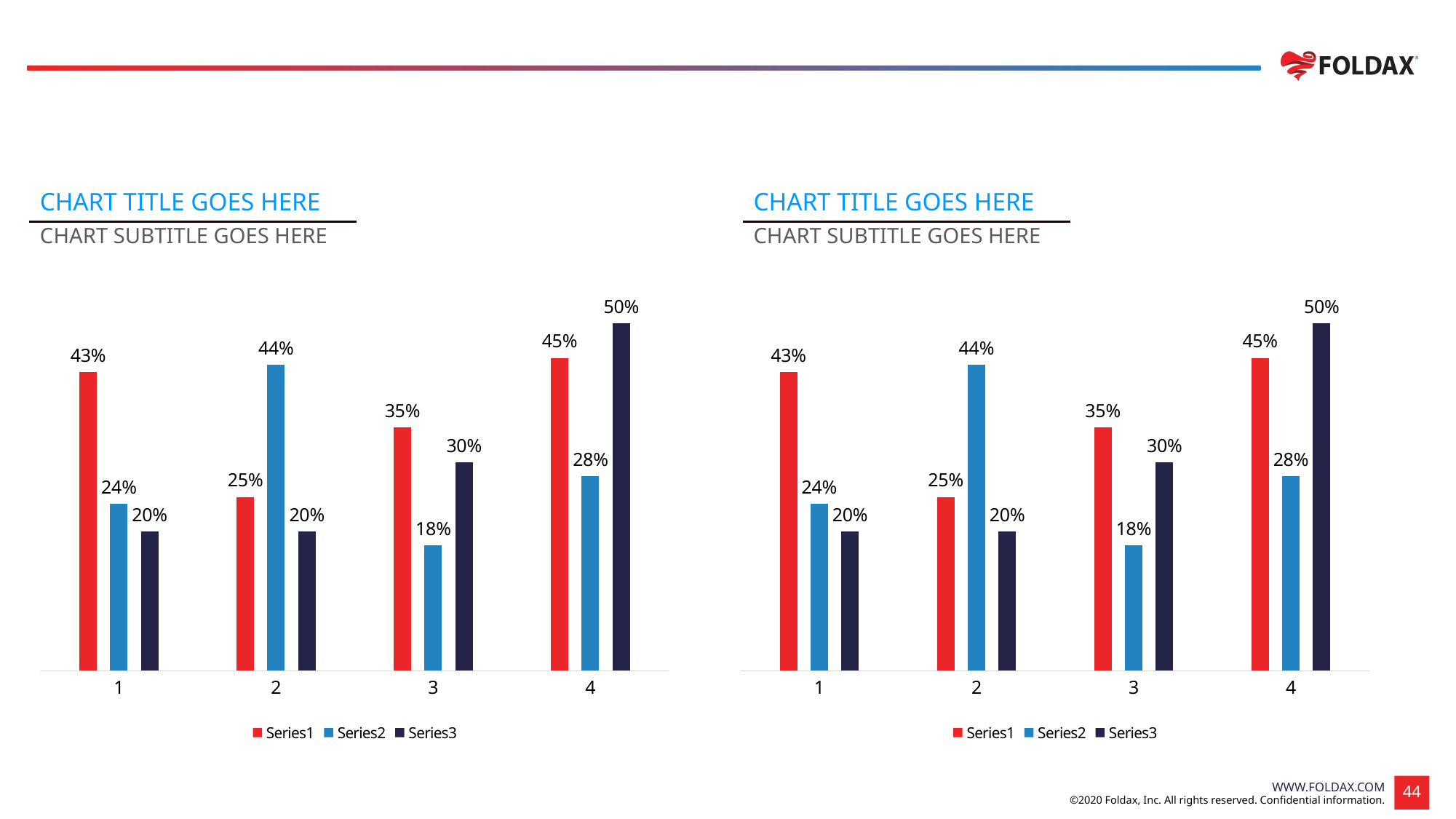
In the left chart, what is the value of Series2 for category 3? 18% In the left chart, which category has the lowest Series3 value? 1 and 2 (both 20%) In the right chart, what is the difference between Series3 and Series2 for category 4? 22% In the left chart, what is the value of Series1 for category 1? 43% How many categories are shown on the x axis of the left chart? 4 What colour represents Series1 in the left chart's legend? Red In the right chart, do the Series3 values rise or fall from category 2 to category 4? Rise What type of chart is the left chart? Bar chart In the right chart, which category has the highest Series2 value? 2 In the right chart, what is the value of Series3 for category 4? 50% In the left chart, which is larger for category 3: Series1 or Series3? Series1 How many series does the legend of the right chart list? 3